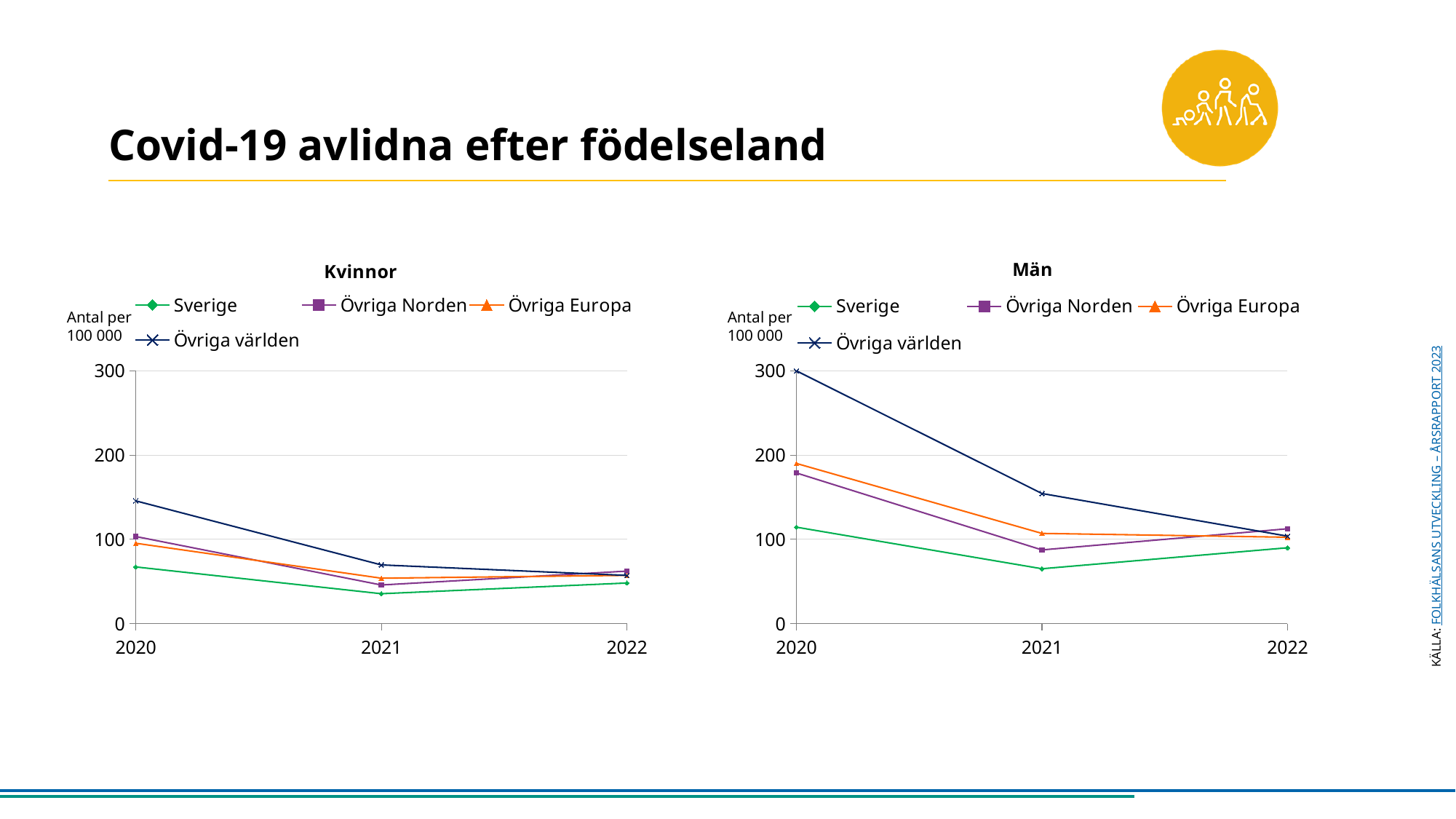
In the Män chart, which series has the lowest value in 2021? Sverige In the Kvinnor chart, is the value for Övriga världen in 2020 greater or less than 100? greater In the Män chart, is the value for Sverige in 2021 greater or less than 100? less What kind of chart is the Kvinnor chart? line chart How many years are shown on the x axis of the Kvinnor chart? 3 What is the y-axis label of the Kvinnor chart? Antal per 100 000 In the Män chart, which is larger in 2020: Övriga Europa or Sverige? Övriga Europa How many series does the legend of the Män chart list? 4 In the Män chart, is the value for Övriga världen in 2021 greater or less than 200? less In the Kvinnor chart, which series has the highest value in 2020? Övriga världen In the Män chart, does the Sverige series rise or fall from 2021 to 2022? rise In the Kvinnor chart, does the Övriga världen series rise or fall from 2020 to 2022? fall